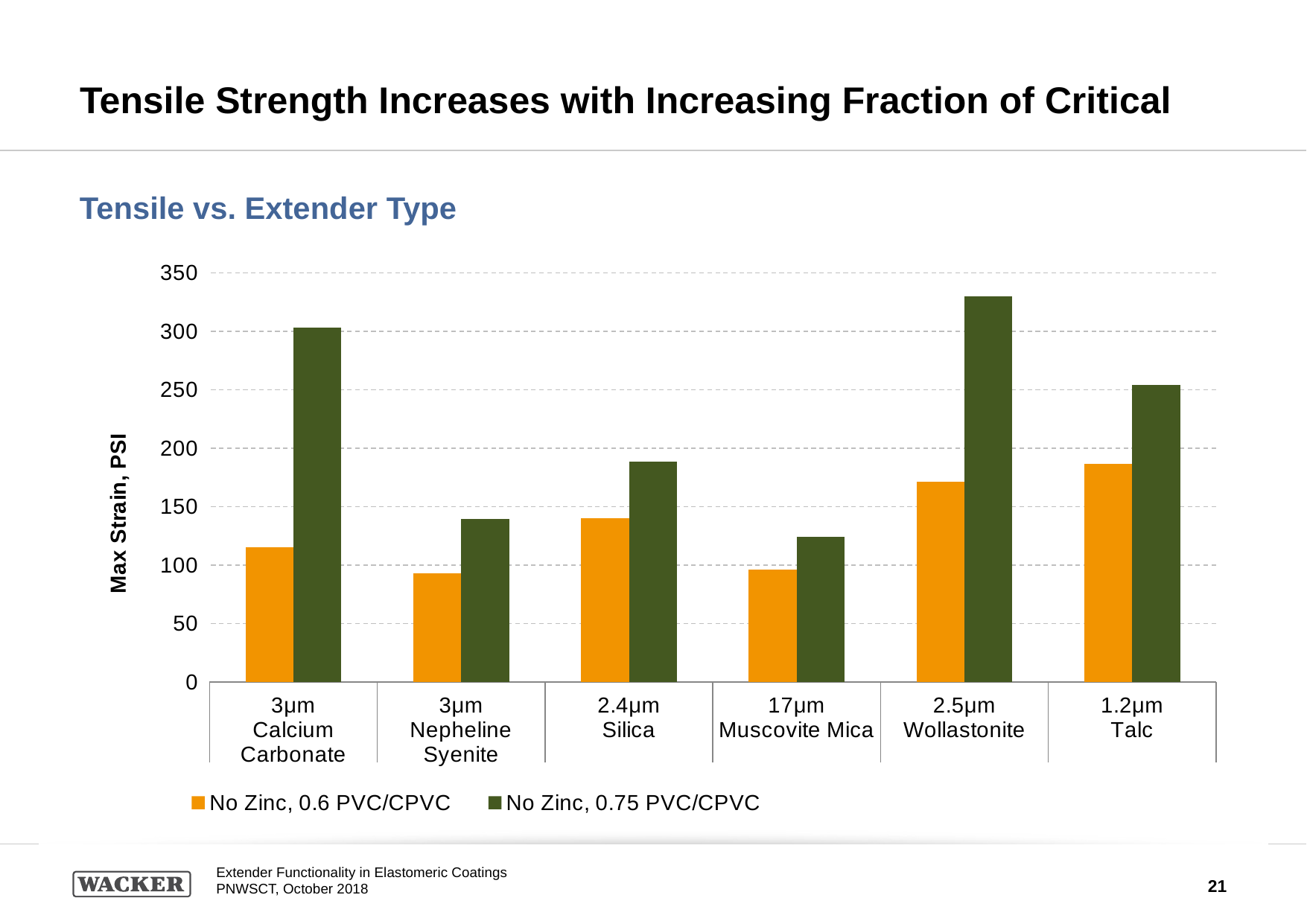
Which extender has the highest value for the No Zinc, 0.75 PVC/CPVC series? 2.5µm Wollastonite Which extender has the lowest value for the No Zinc, 0.75 PVC/CPVC series? 17µm Muscovite Mica Is the No Zinc, 0.6 PVC/CPVC value for 17µm Muscovite Mica greater or less than 150? less Which extender has the highest value for the No Zinc, 0.6 PVC/CPVC series? 1.2µm Talc How many extender types are shown on the x axis? 6 Is the No Zinc, 0.75 PVC/CPVC value for 3µm Calcium Carbonate greater or less than 250? greater How many series does the legend list? 2 What is the label on the y axis of the chart? Max Strain, PSI Is the No Zinc, 0.6 PVC/CPVC value for 1.2µm Talc greater or less than 150? greater What kind of chart is shown on the slide? bar chart For 2.4µm Silica, which series has the larger value: No Zinc, 0.6 PVC/CPVC or No Zinc, 0.75 PVC/CPVC? No Zinc, 0.75 PVC/CPVC